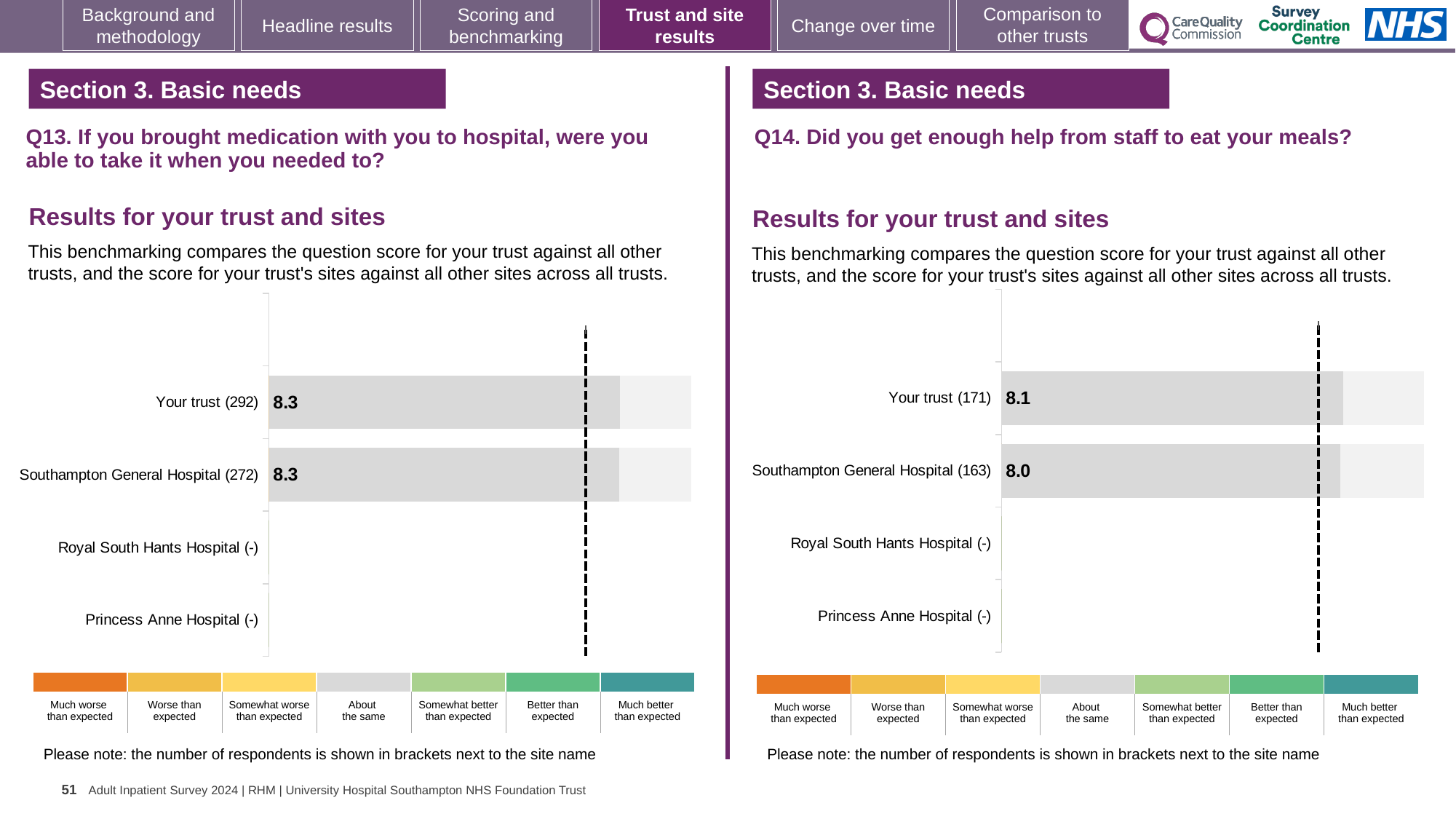
On the Q14 chart (right), what is the score for Southampton General Hospital? 8.0 On the Q13 chart (left), how many respondents are shown in brackets for Your trust? 292 On the Q14 chart (right), what is the difference between the scores for Your trust and Southampton General Hospital? 0.1 On the Q14 chart (right), what is the score for Your trust? 8.1 On the Q13 chart (left), what is the score for Your trust? 8.3 On the Q13 chart (left), which categories have no score shown (marked with a dash)? Royal South Hants Hospital and Princess Anne Hospital On the Q14 chart (right), which has the higher score, Your trust or Southampton General Hospital? Your trust On the Q14 chart (right), how many respondents are shown in brackets for Southampton General Hospital? 163 How many site/trust categories are listed on the Q13 chart (left)? 4 What kind of chart is used on the Q14 chart (right)? Bar chart How many benchmark categories does the colour legend below the Q14 chart (right) list? 7 On the Q13 chart (left), what is the score for Southampton General Hospital? 8.3